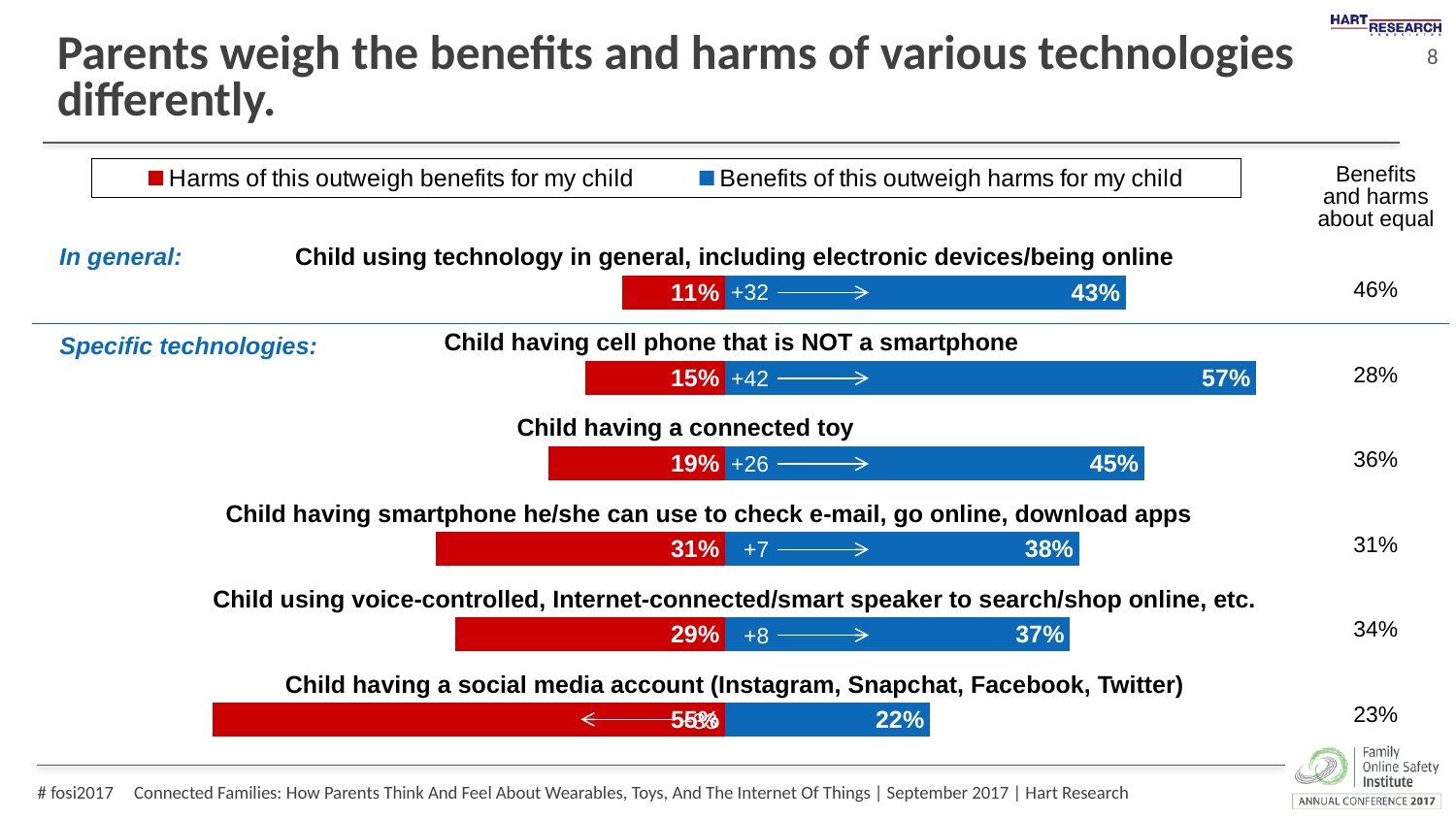
What percentage of parents say the harms outweigh the benefits for a child having a connected toy? 19% What is the difference between the benefits-outweigh-harms and harms-outweigh-benefits percentages for a child having a smartphone? +7 How many technologies are shown in the chart? 6 Which technology has the highest share of parents saying benefits outweigh harms? Child having cell phone that is NOT a smartphone Which is larger for a child using a voice-controlled smart speaker: the share saying harms outweigh benefits or the share saying benefits outweigh harms? Benefits outweigh harms (37%) What kind of chart is shown on the slide? Bar chart What percentage of parents say benefits and harms are about equal for a child using technology in general? 46% Which technology has the lowest share of parents saying harms outweigh benefits? Child using technology in general, including electronic devices/being online Which colour represents 'Benefits of this outweigh harms for my child' in the legend? Blue How many series does the legend list? 2 What percentage of parents say the benefits outweigh the harms for a child having a social media account? 22% What percentage of parents say the benefits outweigh the harms for a child having a cell phone that is NOT a smartphone? 57%